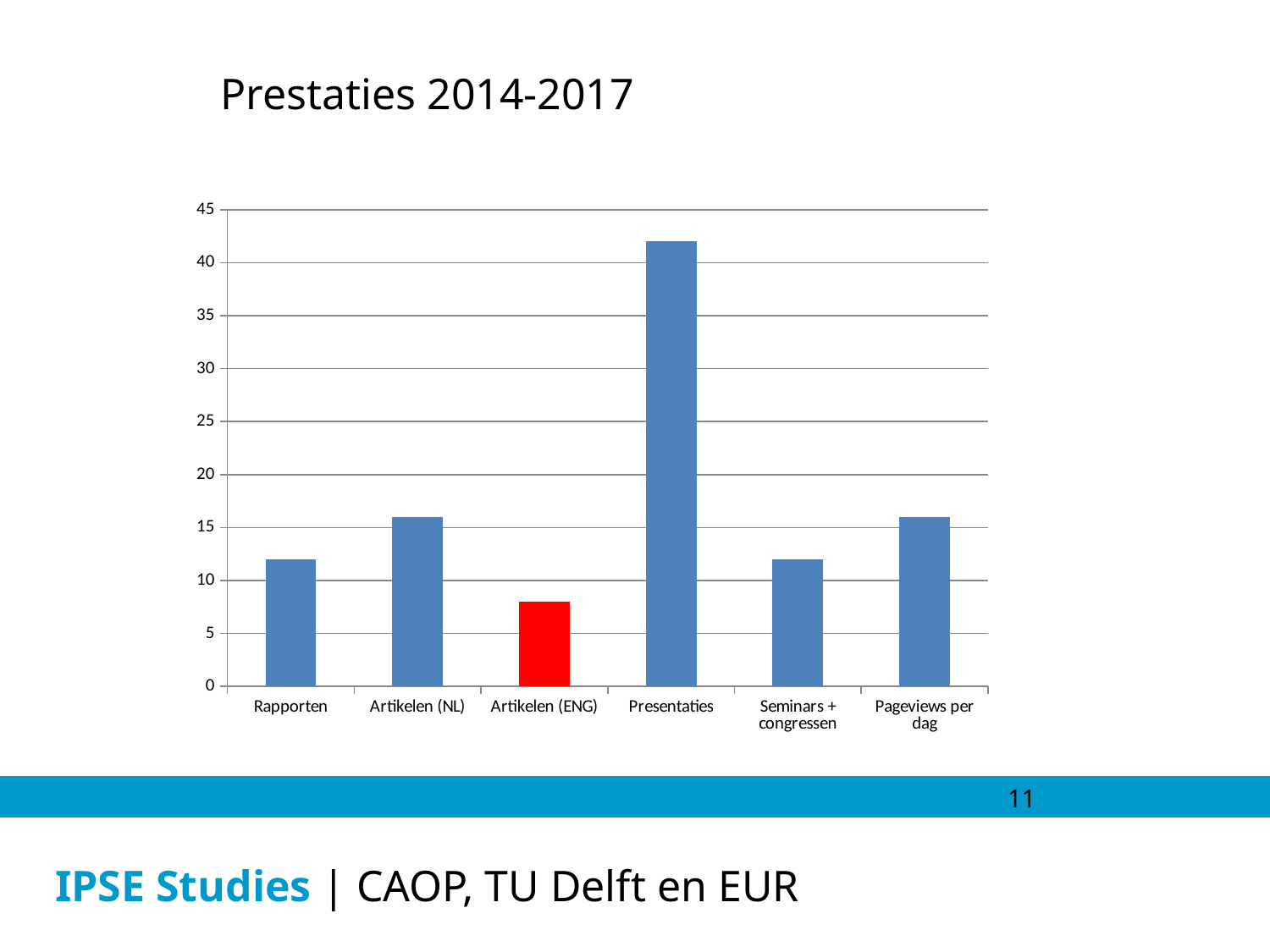
What kind of chart is shown on the slide? bar chart Is the value for Pageviews per dag greater or less than 15? greater Which is larger, the value for Presentaties or the value for Seminars + congressen? Presentaties How many categories are shown on the x axis of the chart? 6 Is the value for Artikelen (ENG) greater or less than 10? less Which category has the highest bar in the chart? Presentaties Which category has the lowest bar in the chart? Artikelen (ENG) Is the value for Artikelen (NL) greater or less than 20? less Which is larger, the value for Artikelen (NL) or the value for Artikelen (ENG)? Artikelen (NL) Which category's bar is coloured red in the chart? Artikelen (ENG)